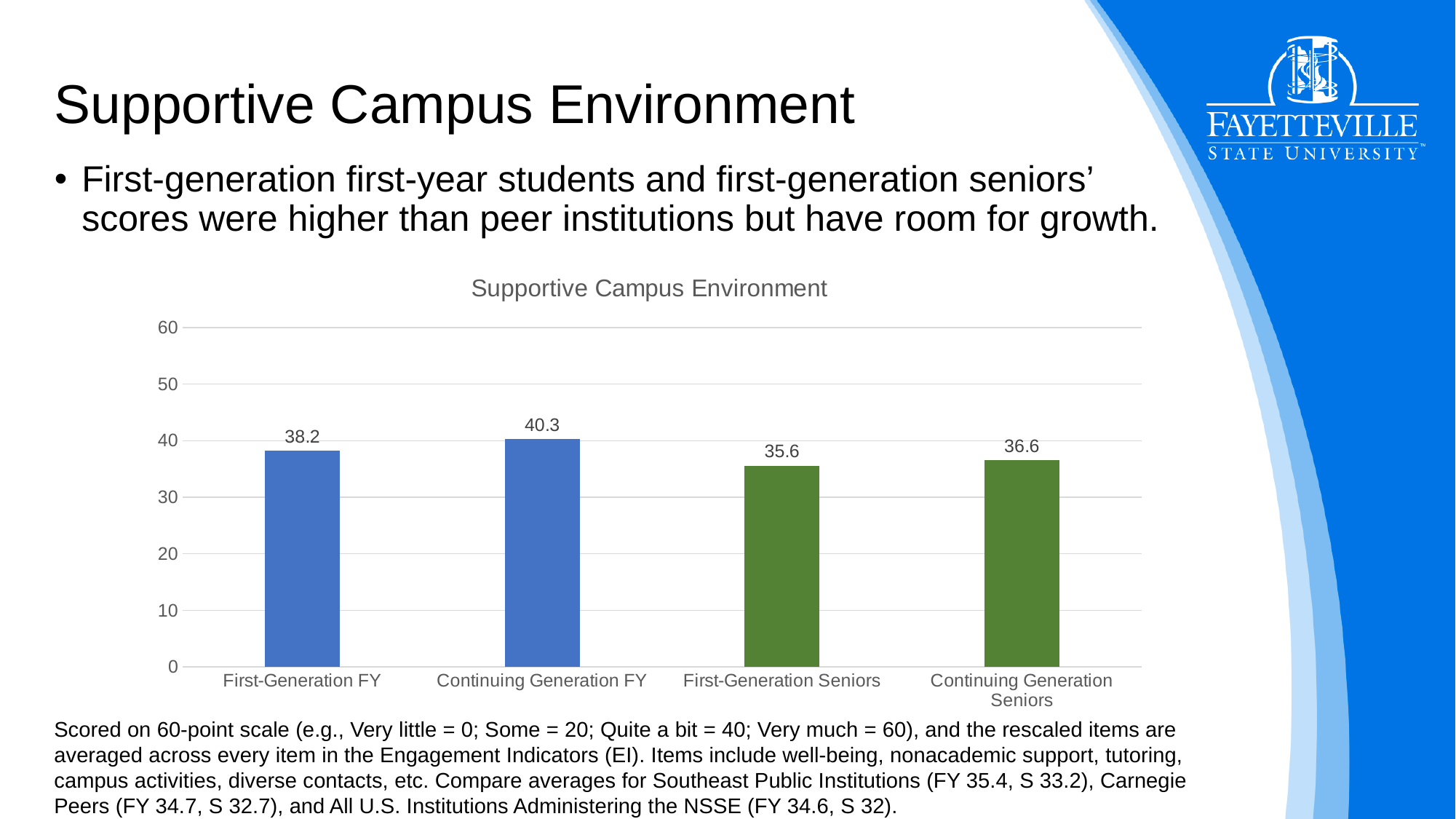
What kind of chart is shown on the slide? Bar chart What is the title of the chart? Supportive Campus Environment What is the value for Continuing Generation Seniors? 36.6 Which category has the lowest value? First-Generation Seniors What is the value for First-Generation FY? 38.2 What is the difference between Continuing Generation FY and First-Generation FY? 2.1 Which is larger, First-Generation Seniors or Continuing Generation Seniors? Continuing Generation Seniors How many categories are shown in the chart? 4 Which category has the highest value? Continuing Generation FY Is the value for Continuing Generation FY greater or less than 40? greater What is the value for Continuing Generation FY? 40.3 What is the value for First-Generation Seniors? 35.6